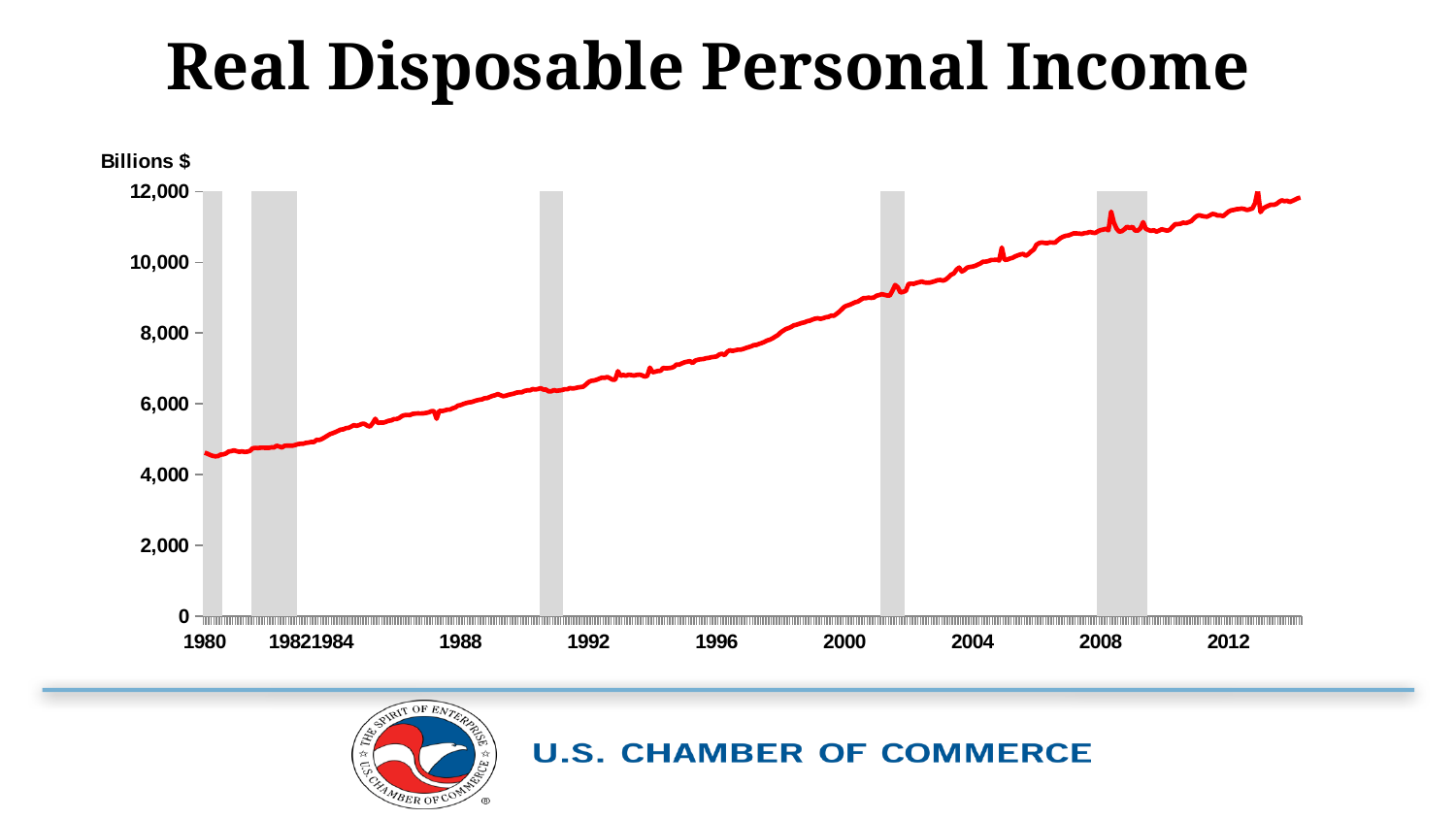
Is the value for 1988 greater or less than 8,000? less Is the value for 1996 greater or less than 6,000? greater What kind of chart is shown on the slide? line chart What unit is shown on the vertical axis label? Billions $ Is the value for 2008 greater or less than 10,000? greater Which is larger, the value for 1980 or the value for 2012? 2012 What is the title of the chart? Real Disposable Personal Income Do the values generally rise or fall from 1980 to 2012? rise